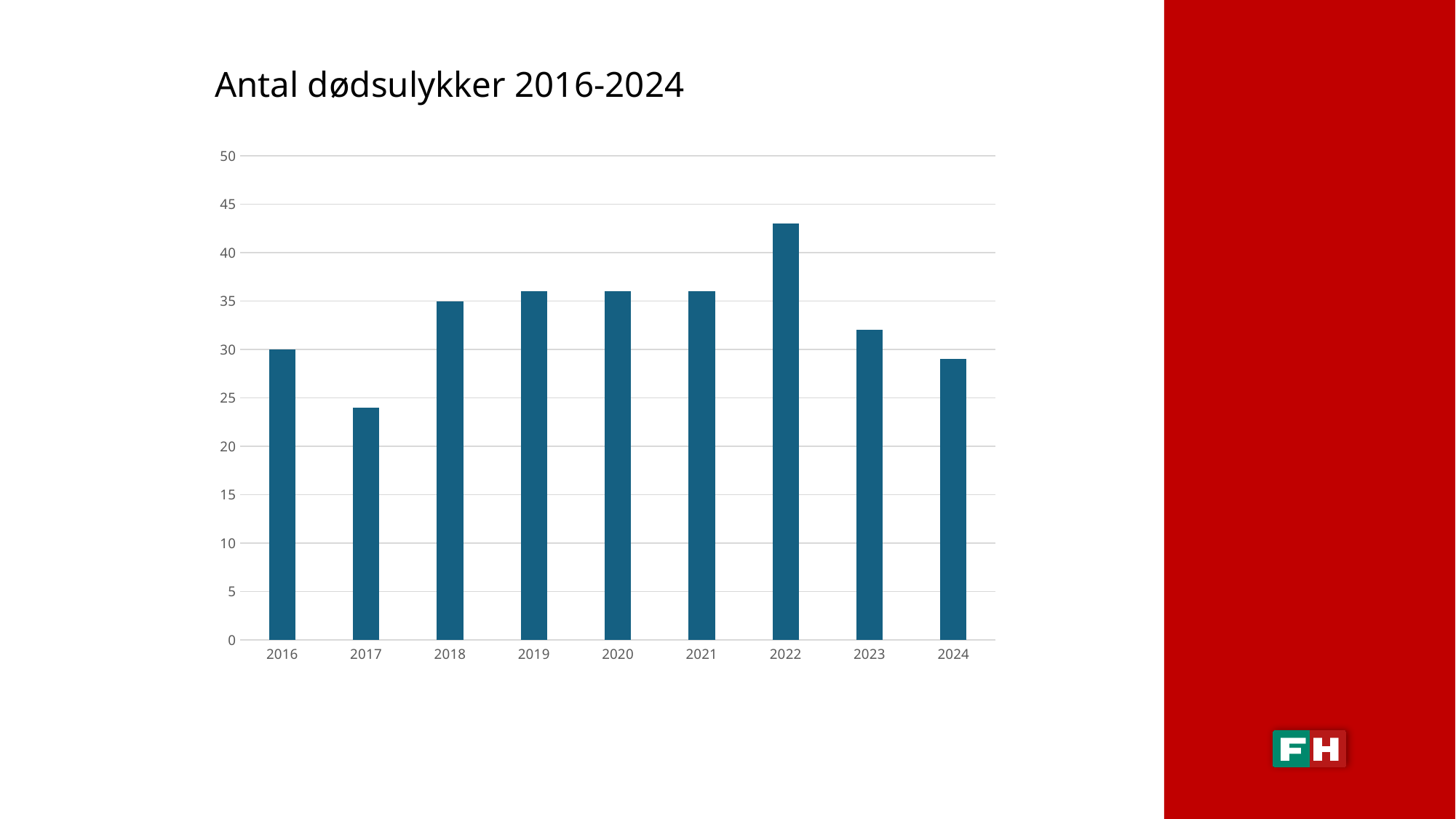
Is the value for 2022 greater or less than 40? greater Which is larger, the value for 2022 or the value for 2023? 2022 What is the value for 2018? 35 What is the value for 2016? 30 Do the values rise or fall from 2022 to 2024? fall Which year has the lowest value in the chart? 2017 Which year has the highest value in the chart? 2022 What is the difference between the values for 2018 and 2016? 5 How many years are shown on the x axis of the chart? 9 What type of chart is shown on the slide? bar chart What is the title of the chart? Antal dødsulykker 2016-2024 Is the value for 2017 greater or less than 25? less